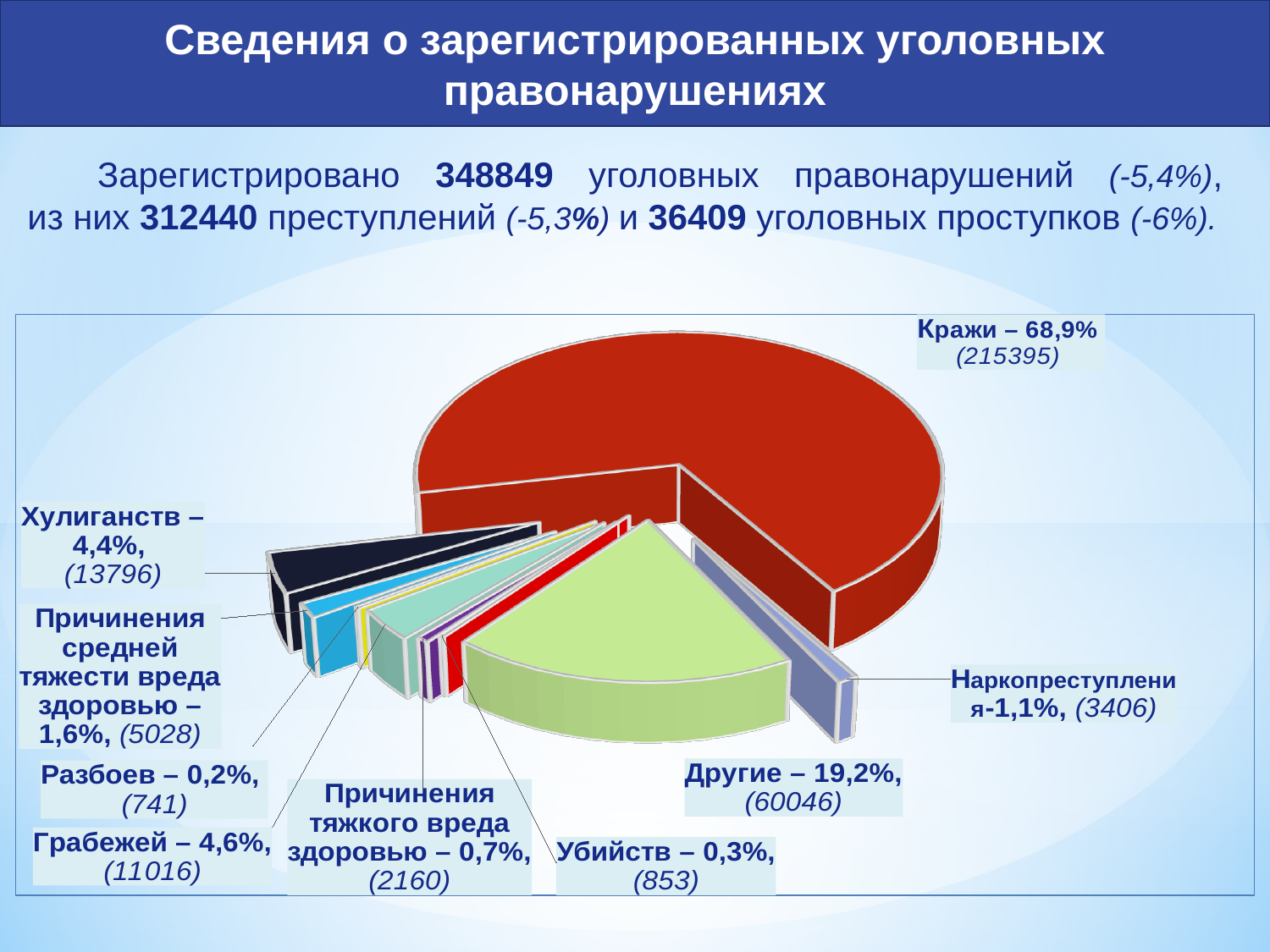
Сколько краж указано на диаграмме? 215395 Какую долю на круговой диаграмме занимают кражи? 68,9% Какая категория на диаграмме имеет наибольшую долю? Кражи Сколько категорий показано на круговой диаграмме? 9 Сколько грабежей указано на диаграмме? 11016 Какова доля категории «Другие» на диаграмме? 19,2% Что больше: число хулиганств или число грабежей? Хулиганств На сколько число убийств больше числа разбоев? 112 Какова доля наркопреступлений на диаграмме? 1,1% Какая категория на диаграмме имеет наименьшую долю? Разбоев Сколько случаев причинения тяжкого вреда здоровью указано на диаграмме? 2160 Какой тип диаграммы показан на слайде? Круговая диаграмма